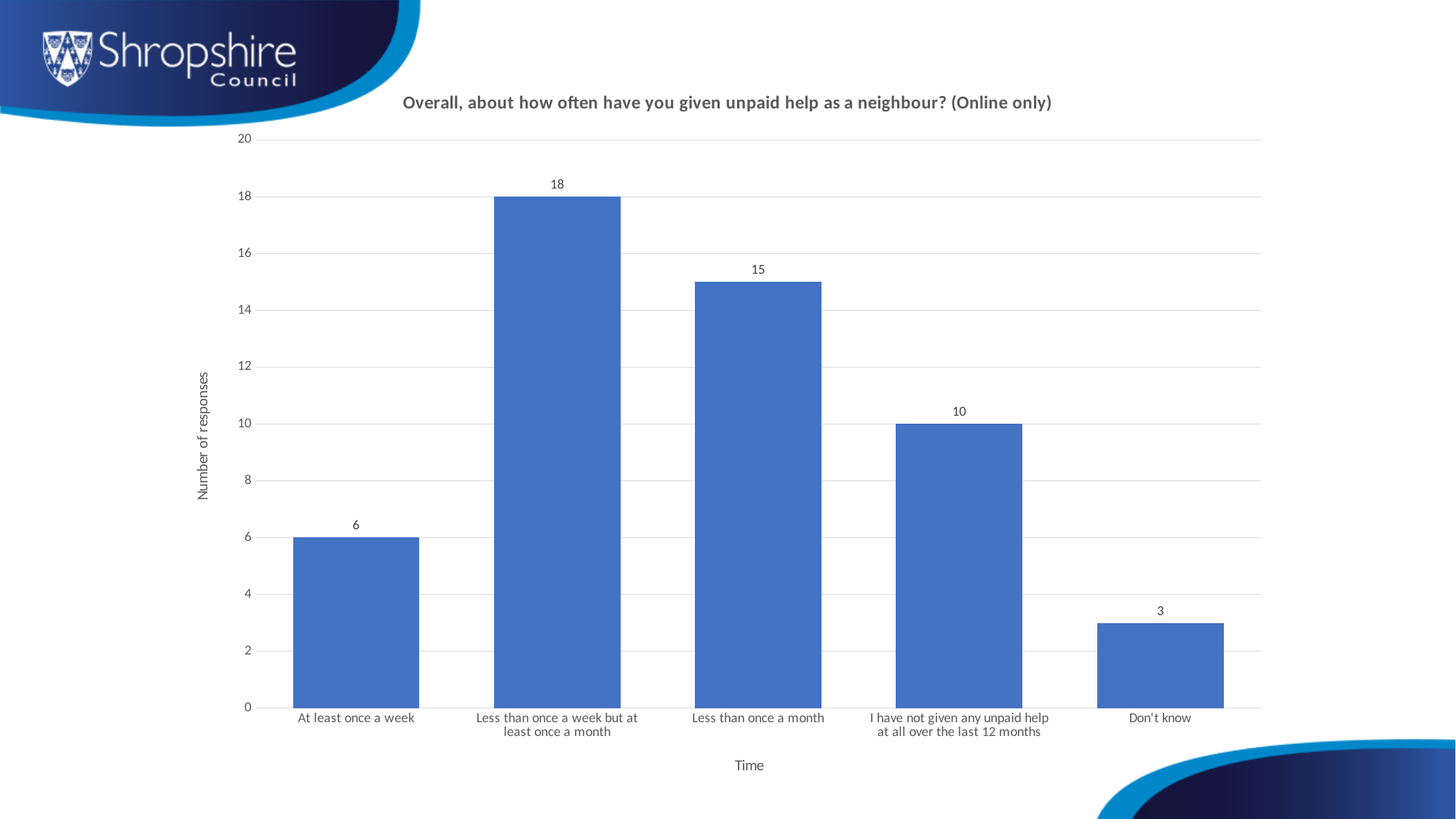
Which category has the highest number of responses? Less than once a week but at least once a month How many responses are shown for 'At least once a week'? 6 Is the value for 'I have not given any unpaid help at all over the last 12 months' greater or less than 8? greater How many categories are shown on the x axis? 5 What is the label of the vertical axis? Number of responses What kind of chart is shown on the slide? Bar chart Which has more responses: 'At least once a week' or 'Less than once a month'? Less than once a month How many responses are shown for 'Don't know'? 3 What is the difference between the values for 'Less than once a month' and 'I have not given any unpaid help at all over the last 12 months'? 5 Which category has the lowest number of responses? Don't know What is the value for 'Less than once a week but at least once a month'? 18 What is the title of the chart? Overall, about how often have you given unpaid help as a neighbour? (Online only)